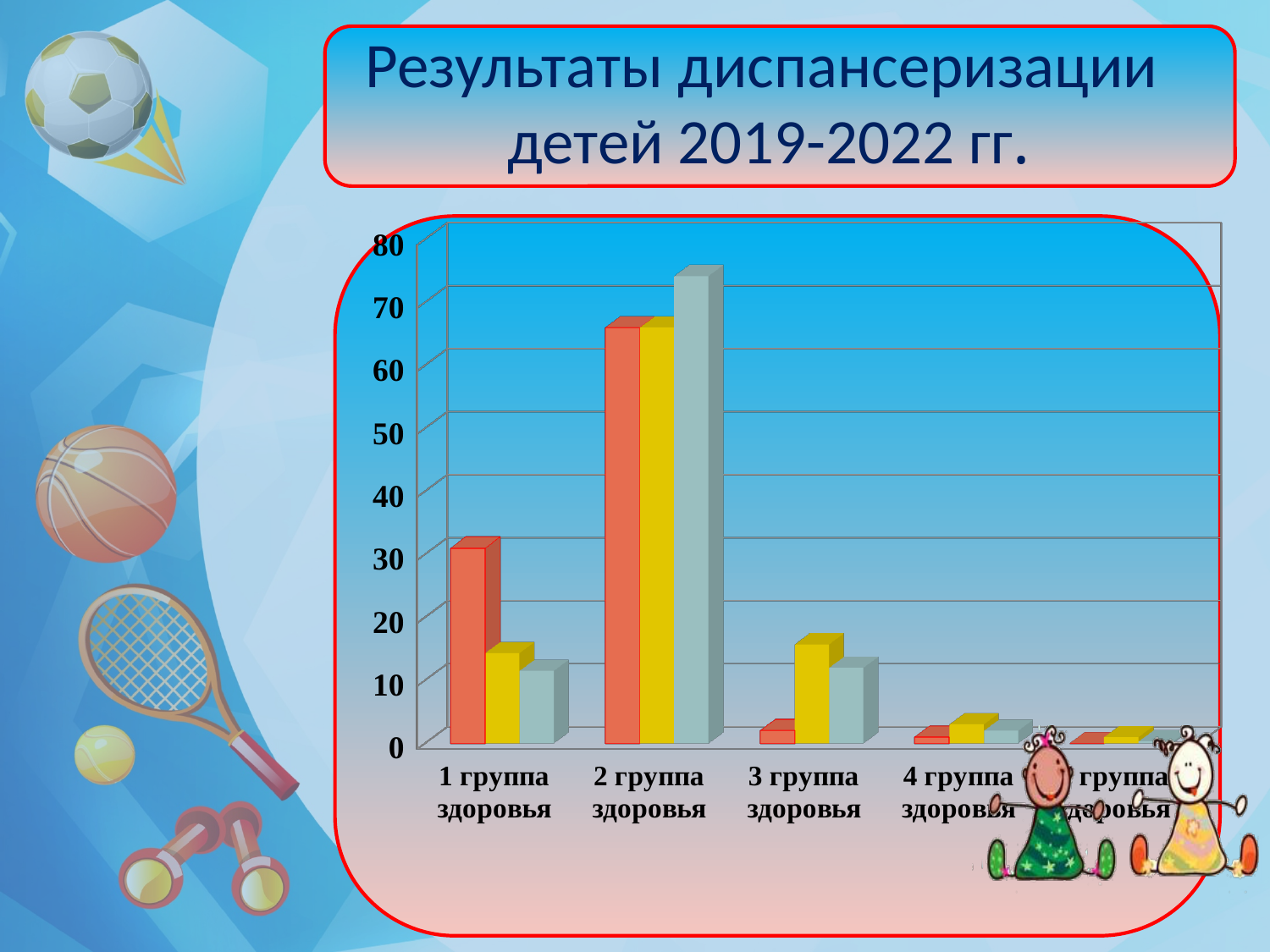
Is the value of the light blue bar for 2 группа здоровья greater or less than 70? greater Is the value of the red bar for 1 группа здоровья greater or less than 40? less Is the value of the red bar for 2 группа здоровья greater or less than 60? greater How many health-group categories are shown along the x axis of the chart? 5 Which health group has the tallest bars in the chart? 2 группа здоровья For 1 группа здоровья, which bar is taller: the red bar or the yellow bar? the red bar What kind of chart is shown on the slide? bar chart What is the title of the slide containing the chart? Результаты диспансеризации детей 2019-2022 гг. For 3 группа здоровья, which bar is taller: the red bar or the yellow bar? the yellow bar